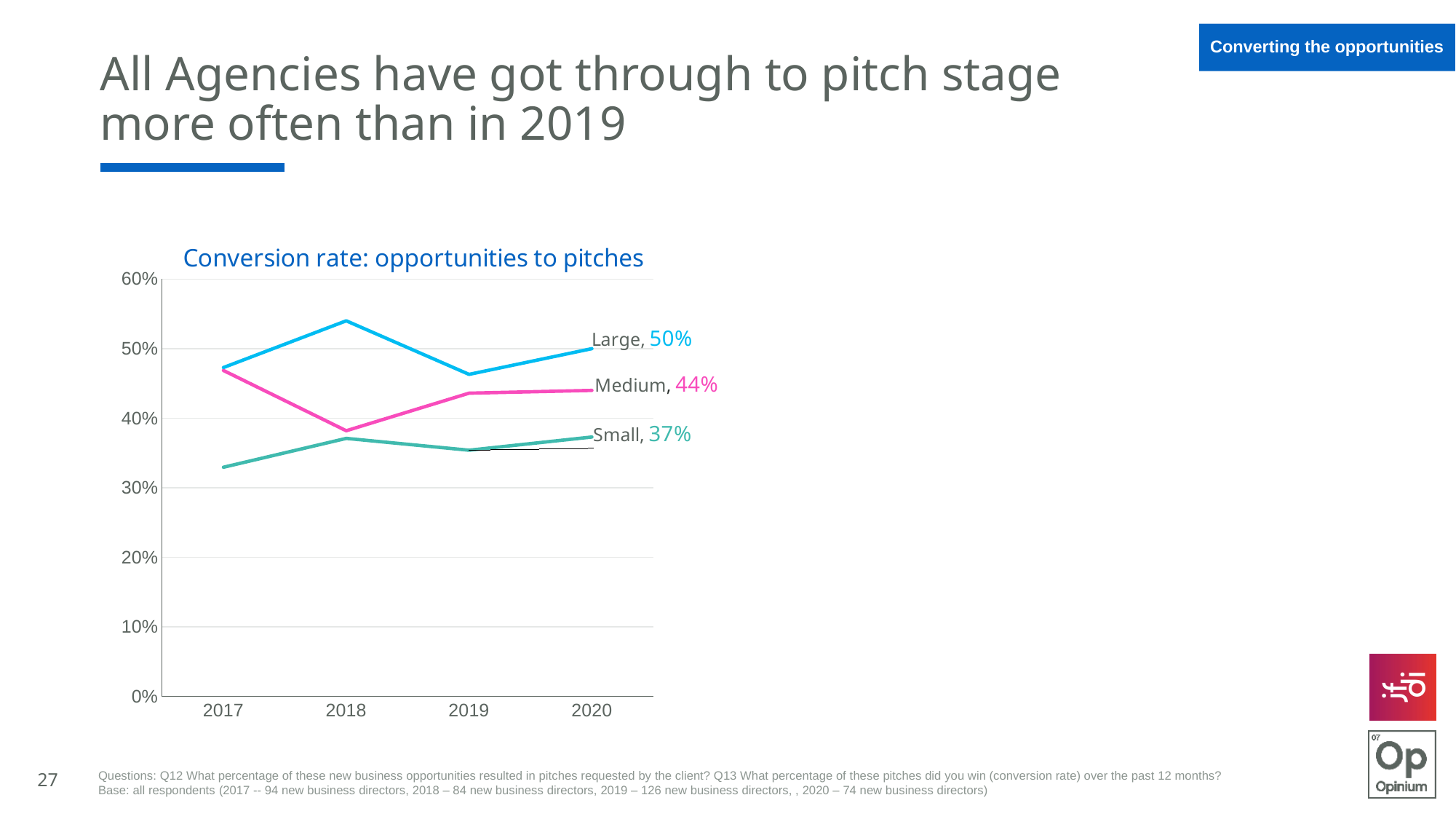
How many years are shown on the x axis? 4 What is the value for Large in 2020? 50% What is the value for Small in 2020? 37% How many series are plotted on the chart? 3 What is the difference between the Large and Small values in 2020? 13 percentage points Is the value for Small in 2017 greater or less than 40%? less Which series has the lowest value in 2020? Small Which is larger in 2020, Medium or Small? Medium Is the value for Large in 2018 greater or less than 50%? greater Which series has the highest value in 2020? Large What kind of chart is shown on the slide? Line chart What is the value for Medium in 2020? 44%